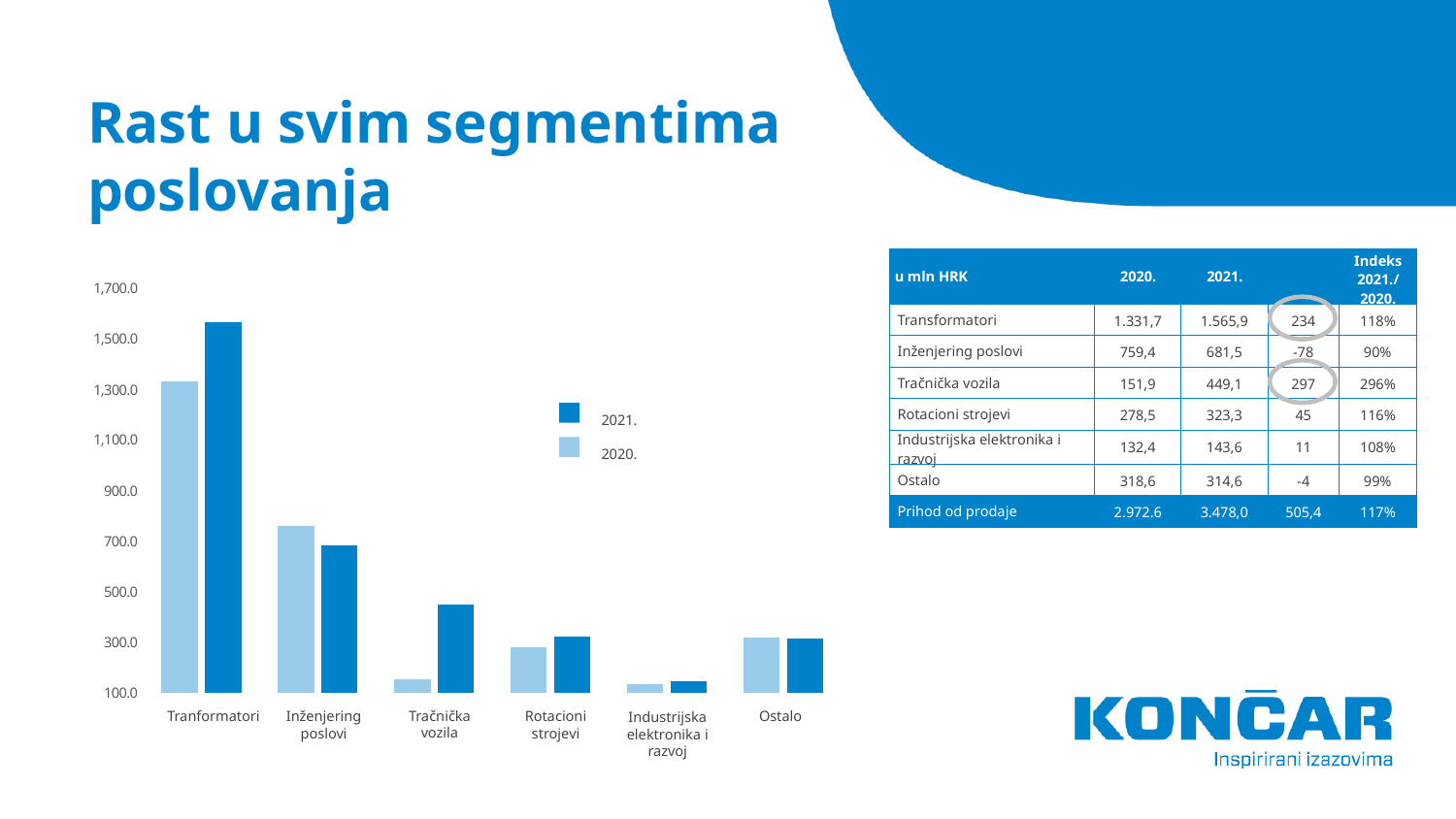
For Inženjering poslovi, which bar is taller, 2021. or 2020.? 2020. Which category has the highest bar for 2021. in the chart? Tranformatori Is the 2021. value for Tračnička vozila greater or less than 500.0? less Which series is shown in the darker blue colour in the chart? 2021. Is the 2020. value for Inženjering poslovi greater or less than 700.0? greater How many categories are shown on the x axis of the chart? 6 For Tračnička vozila, which bar is taller, 2021. or 2020.? 2021. What kind of chart is shown on the slide? bar chart How many series does the chart legend list? 2 Is the 2021. value for Tranformatori greater or less than 1,500.0? greater Which category has the lowest bar for 2021. in the chart? Industrijska elektronika i razvoj